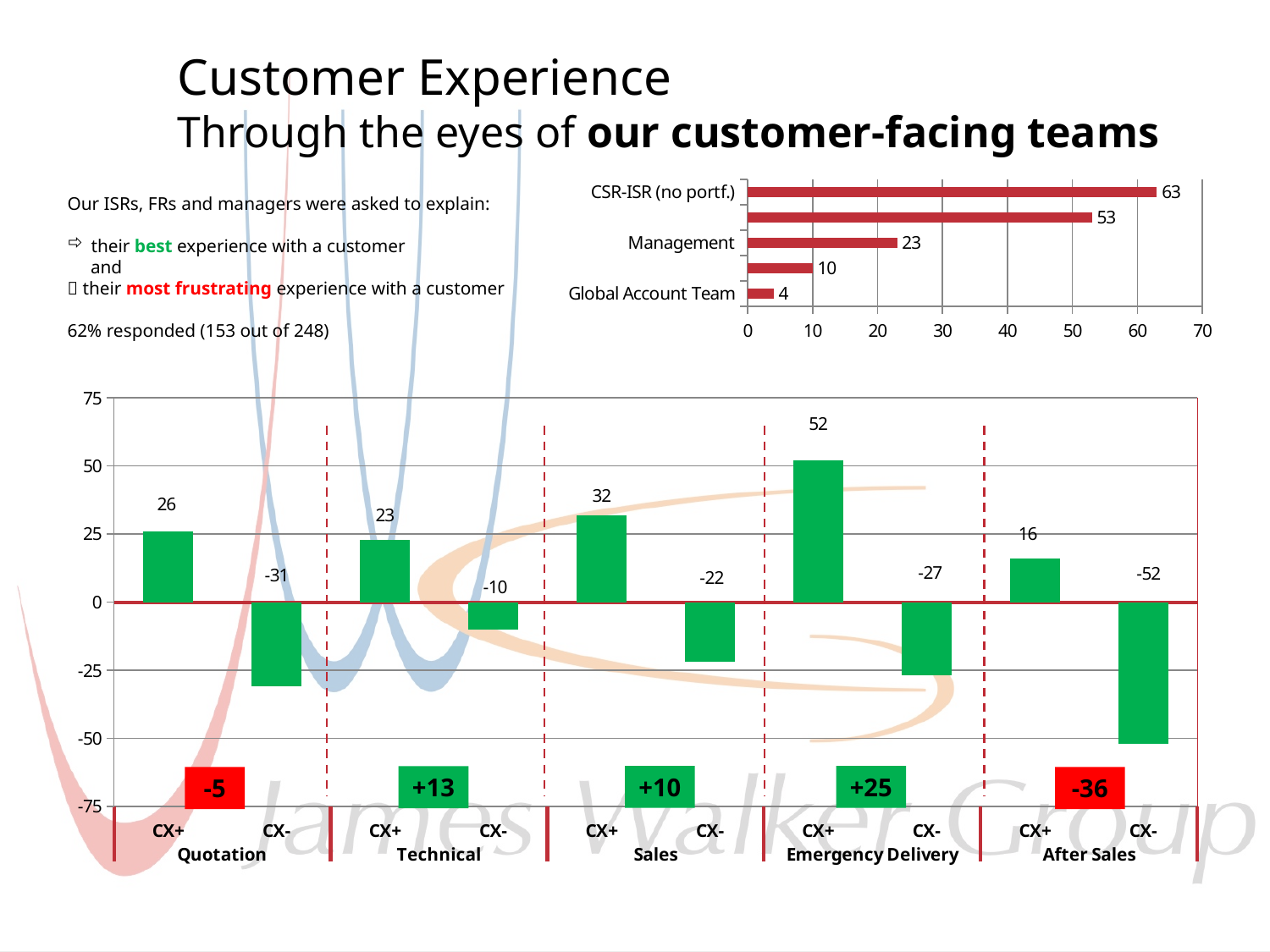
In the top-right chart, what is the difference between the CSR-ISR (no portf.) value and the Management value? 40 In the bottom chart, which group has the highest CX+ value? Emergency Delivery In the top-right chart, which labelled category has the highest value? CSR-ISR (no portf.) In the bottom chart, what is the CX- value for After Sales? -52 In the top-right chart, what is the value for Global Account Team? 4 In the bottom chart, which is larger: the CX+ value for Sales or the CX+ value for Technical? Sales What type of chart is the bottom chart? Bar chart In the bottom chart, what is the CX+ value for Emergency Delivery? 52 In the top-right chart, what is the value for CSR-ISR (no portf.)? 63 In the top-right chart, what is the value for Management? 23 In the bottom chart, which group has the lowest CX- value? After Sales In the bottom chart, what is the difference between the CX+ value for Quotation and the CX+ value for After Sales? 10